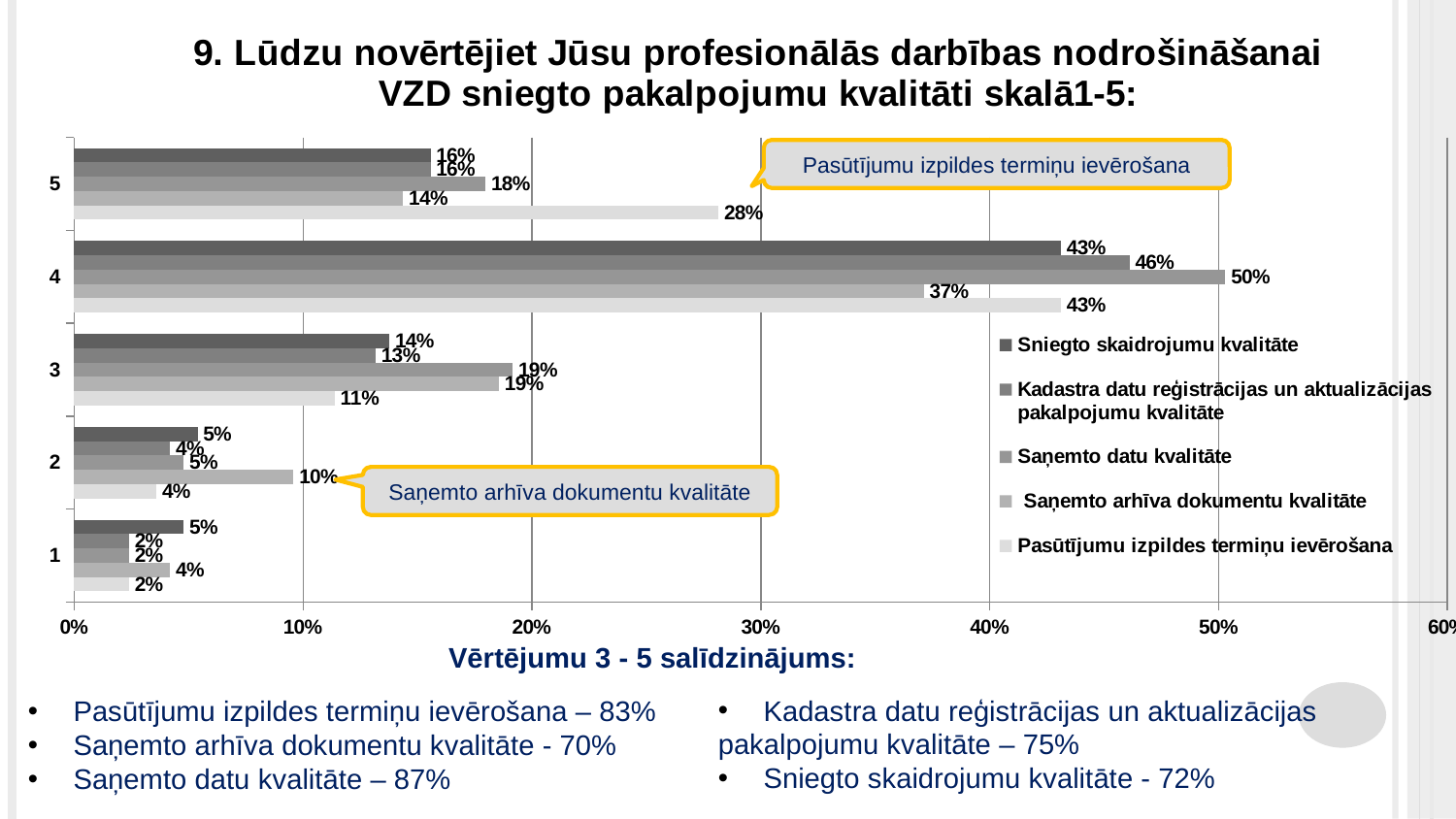
Which series has the highest value at rating 4? Saņemto datu kvalitāte At rating 4, what is the difference between Saņemto datu kvalitāte and Saņemto arhīva dokumentu kvalitāte? 13 percentage points Which series has the lowest value at rating 4? Saņemto arhīva dokumentu kvalitāte How many rating categories are shown on the vertical axis? 5 At rating 5, which is larger: Pasūtījumu izpildes termiņu ievērošana or Saņemto datu kvalitāte? Pasūtījumu izpildes termiņu ievērošana What kind of chart is shown on the slide? bar chart What is the value for Saņemto arhīva dokumentu kvalitāte at rating 2? 10% What is the value for Pasūtījumu izpildes termiņu ievērošana at rating 5? 28% How many series does the legend list? 5 What is the value for Sniegto skaidrojumu kvalitāte at rating 1? 5% What is the value for Saņemto datu kvalitāte at rating 4? 50% Which rating category has the highest values across all series? 4